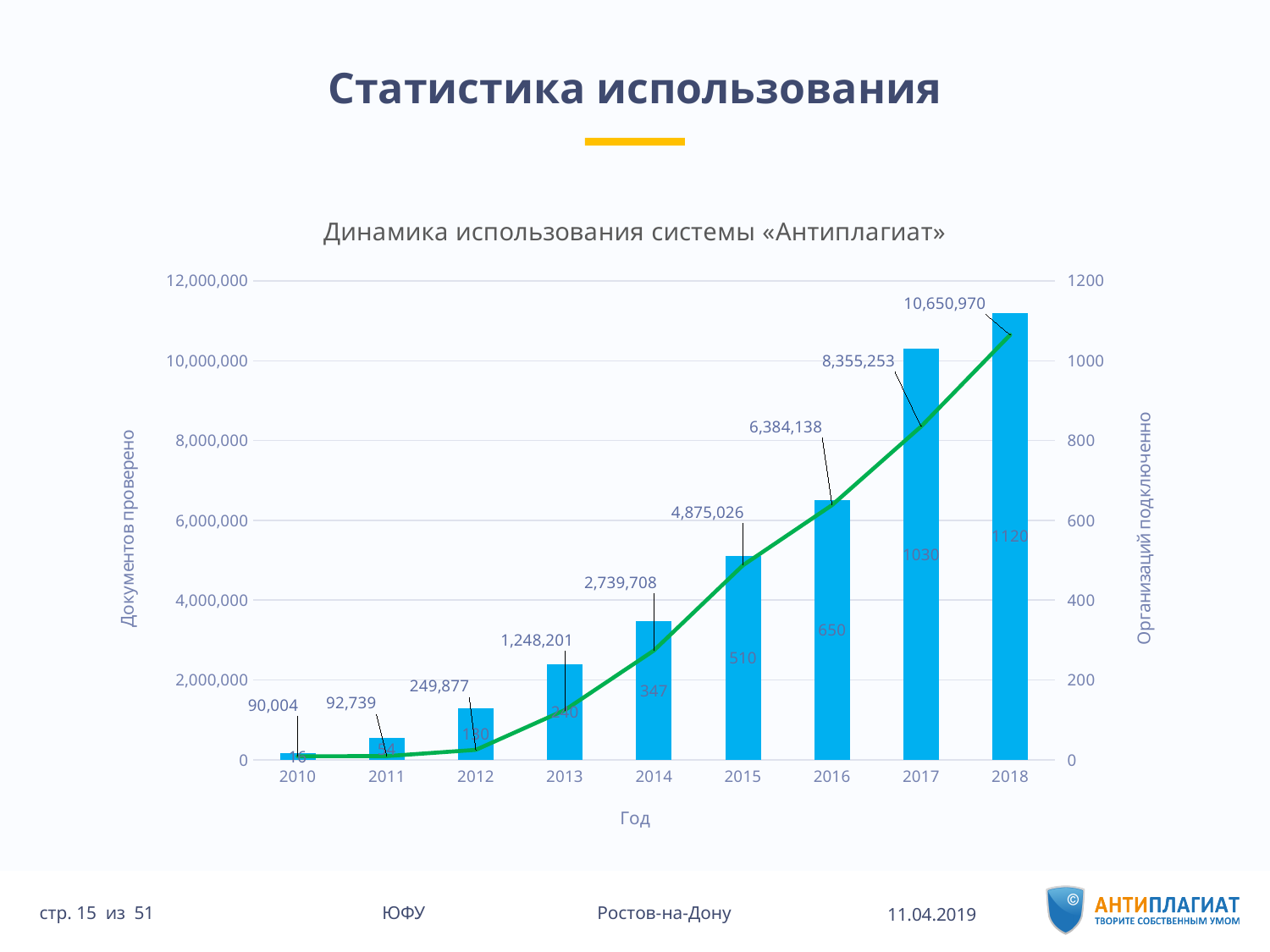
Is the bar value for 2018 (organizations connected) greater or less than 1000 on the right axis? greater How many years are shown on the x axis? 9 What is the number of documents checked (line series) for 2018? 10,650,970 Do the values for documents checked rise or fall from 2010 to 2018? rise What is the number of organizations connected (bar) for 2017? 1030 What is the number of organizations connected (bar) for 2014? 347 What is the number of documents checked (line series) for 2015? 4,875,026 Which year has more documents checked, 2013 or 2014? 2014 What is the difference in organizations connected between 2016 and 2015? 140 Which year has the lowest number of documents checked? 2010 What is the difference in documents checked between 2018 and 2017? 2,295,717 Which year has the highest number of documents checked? 2018